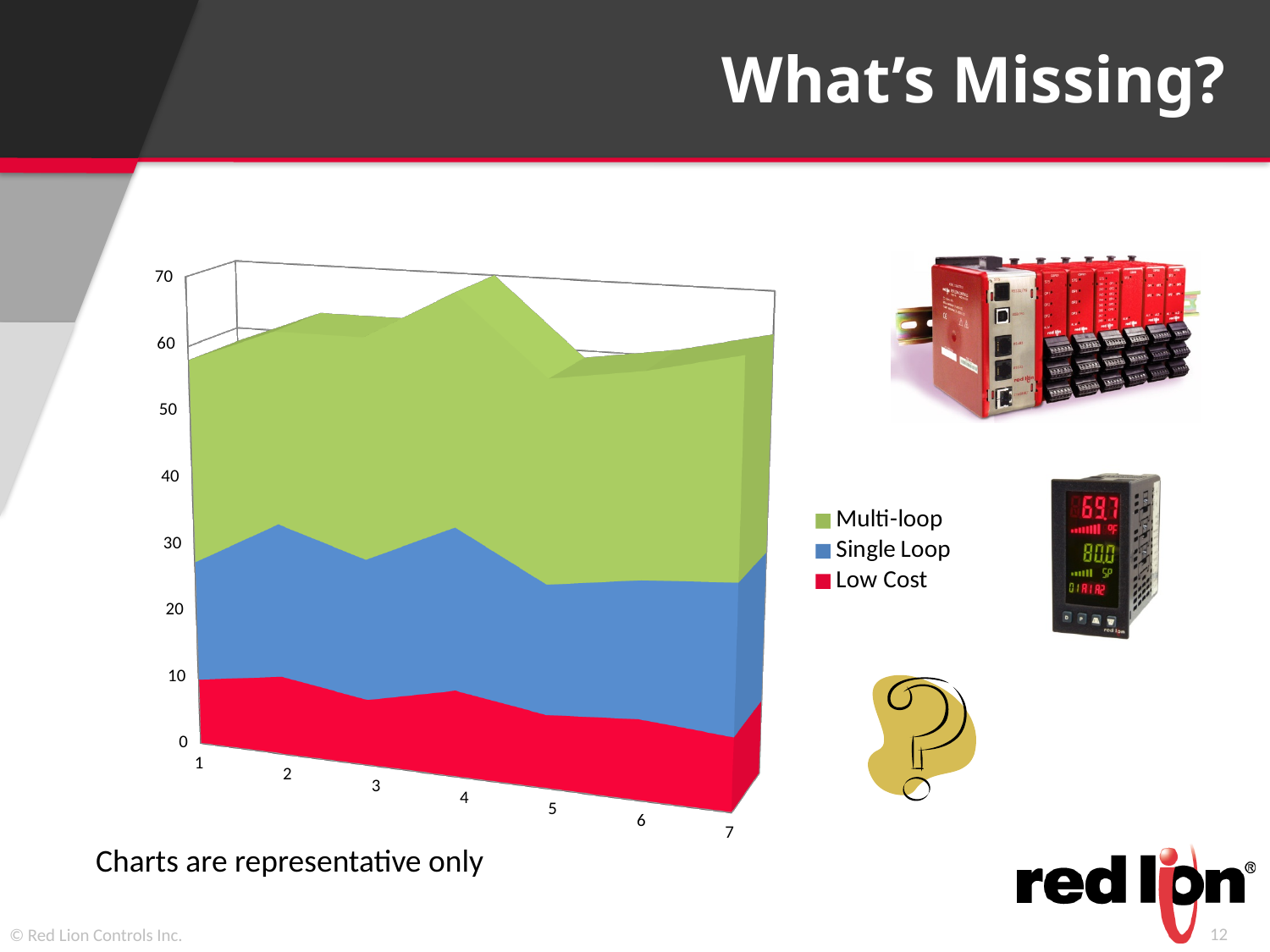
At which x-axis point does the stacked total reach its highest value? 4 Is the Low Cost value at point 5 greater or less than 20? less Which series is plotted at the bottom of the stack in the chart? Low Cost How many series does the chart's legend list? 3 Is the stacked total at point 1 greater or less than 40? greater Is the Low Cost value at point 1 greater or less than 20? less How many points are there along the x axis of the chart? 7 Which series is shown in red in the chart? Low Cost What kind of chart is shown on the slide? Stacked area chart Which series occupies the largest area of the chart at point 4? Multi-loop